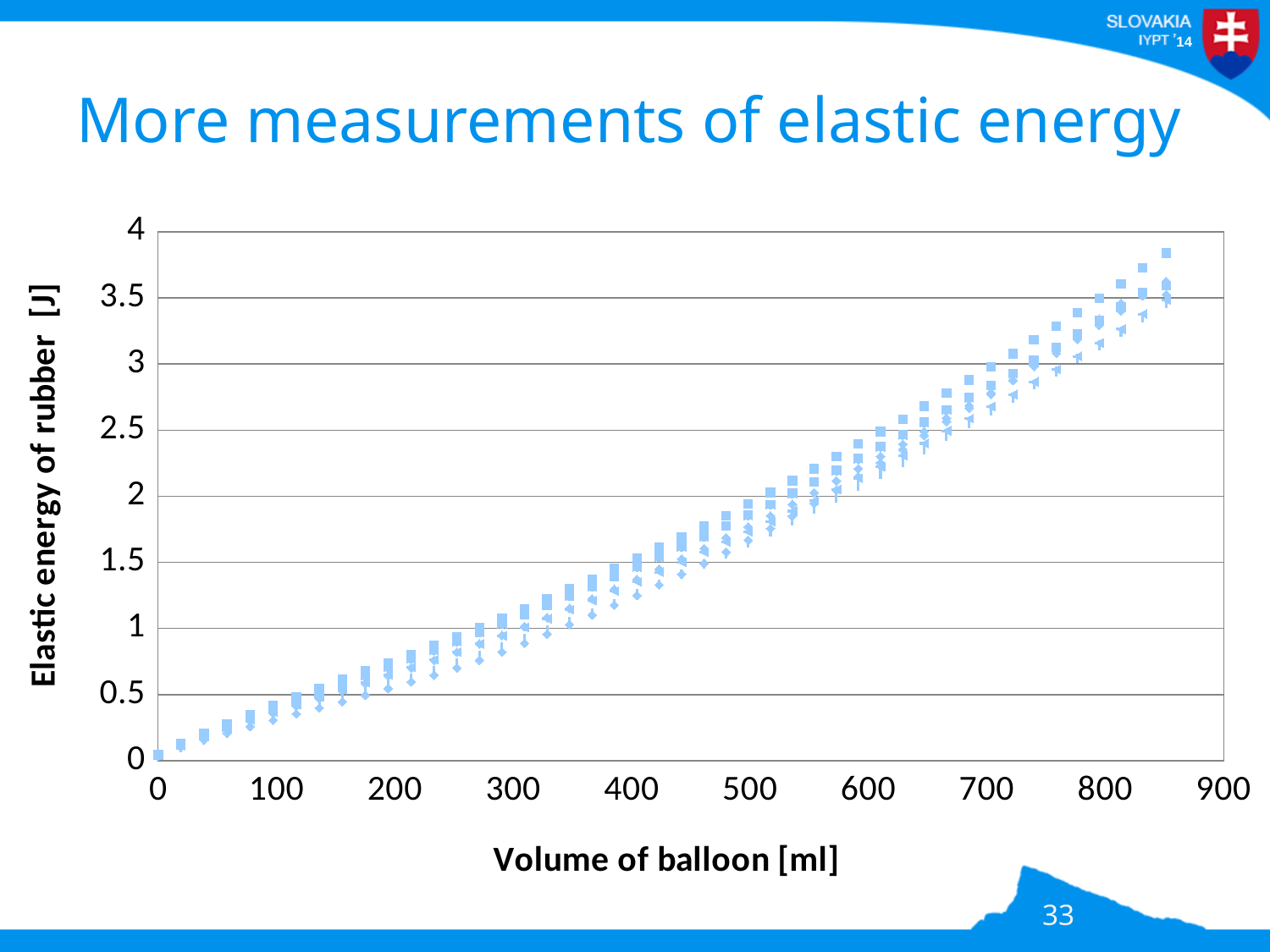
What is the title of the chart? More measurements of elastic energy Is the elastic energy at a balloon volume of 600 ml greater or less than 2 J? greater Do the plotted values rise or fall as the volume of balloon increases? rise Is the elastic energy at a balloon volume of 100 ml greater or less than 0.5 J? less Is the elastic energy at a balloon volume of 800 ml greater or less than 3 J? greater What is the label of the x axis? Volume of balloon [ml] What is the highest value shown on the y axis? 4 Is the elastic energy higher at a balloon volume of 700 ml or at 300 ml? 700 ml What kind of chart is shown on the slide? scatter chart